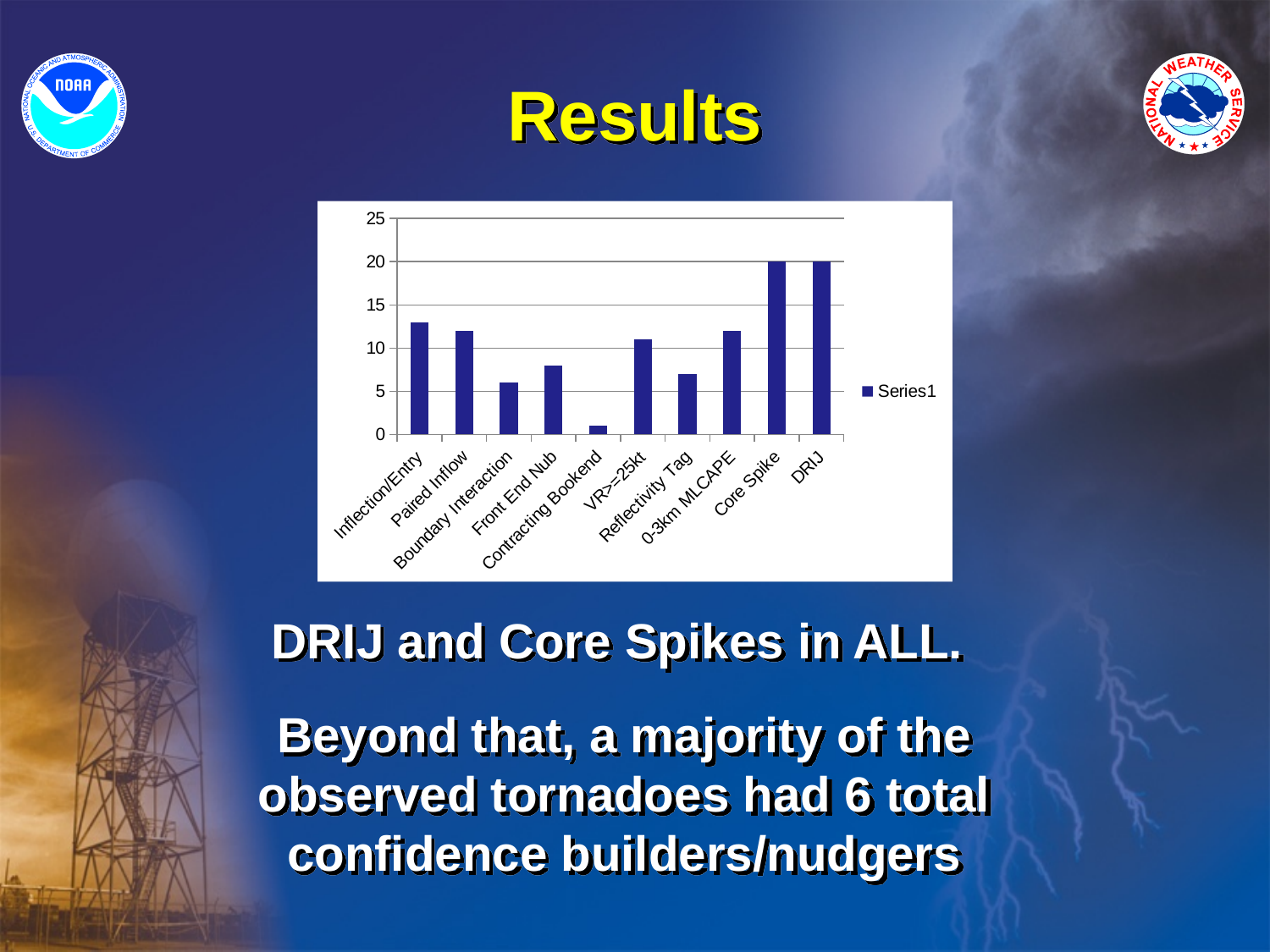
What is the value for Core Spike? 20 Is the value for Reflectivity Tag greater or less than 10? less Is the value for Boundary Interaction greater or less than 10? less Which category has the lowest value? Contracting Bookend How many categories are shown on the x axis of the chart? 10 What is the value for DRIJ? 20 How many series does the chart's legend list? 1 What is the name of the series shown in the legend? Series1 Which is larger, the value for Inflection/Entry or the value for Boundary Interaction? Inflection/Entry Is the value for Inflection/Entry greater or less than 10? greater What kind of chart is shown on the slide? bar chart